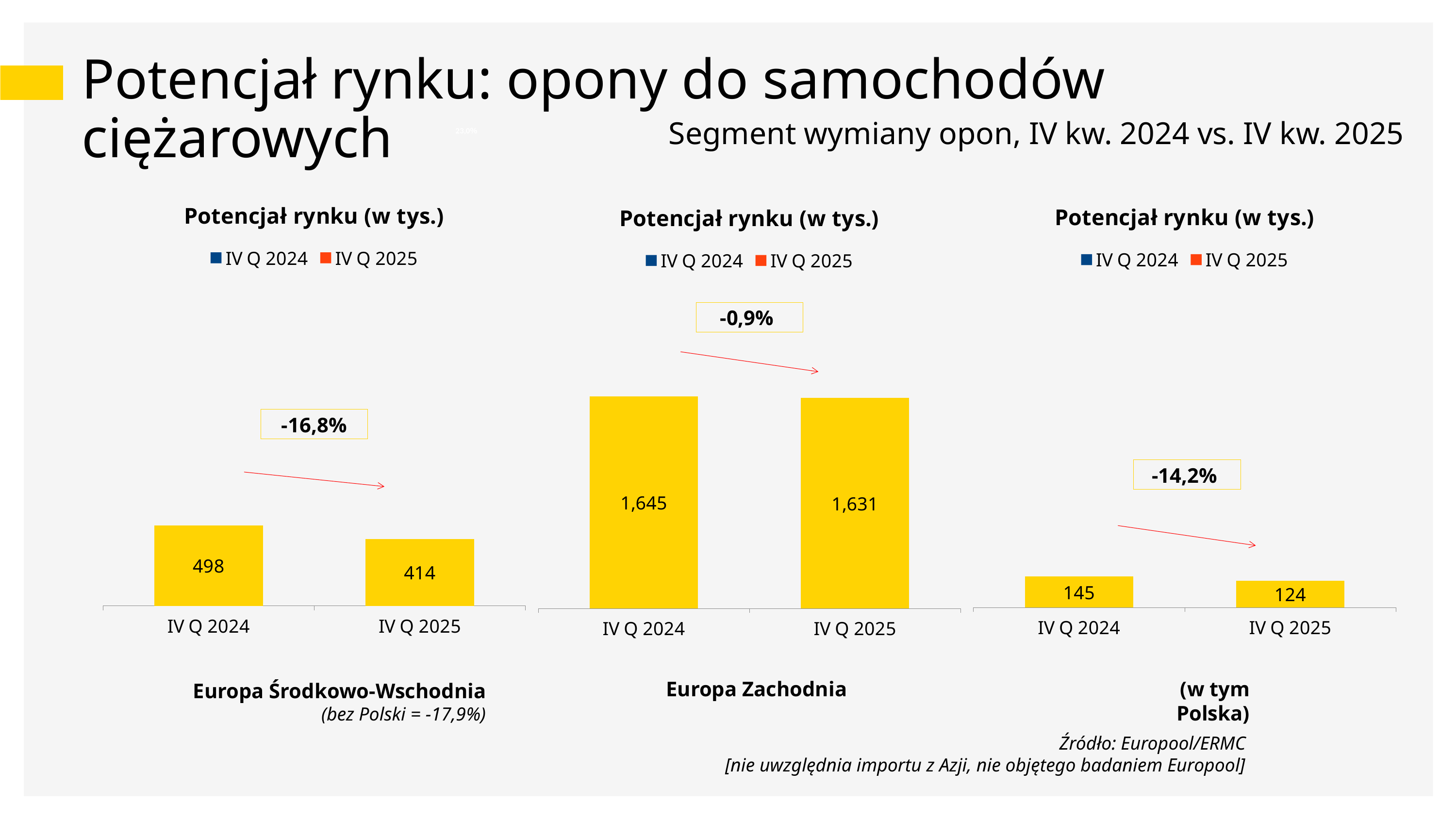
In the left chart (Europa Środkowo-Wschodnia), what is the value for IV Q 2025? 414 In the right chart (Polska), what is the value for IV Q 2025? 124 In the middle chart (Europa Zachodnia), which is larger, IV Q 2024 or IV Q 2025? IV Q 2024 In the middle chart (Europa Zachodnia), what is the value for IV Q 2025? 1,631 How many series does the legend of the middle chart (Europa Zachodnia) list? 2 In the left chart (Europa Środkowo-Wschodnia), what is the value for IV Q 2024? 498 In the right chart (Polska), what is the difference between the IV Q 2024 and IV Q 2025 values? 21 In the left chart (Europa Środkowo-Wschodnia), what is the difference between the IV Q 2024 and IV Q 2025 values? 84 What percentage change is shown above the bars in the middle chart (Europa Zachodnia)? -0,9% In the left chart (Europa Środkowo-Wschodnia), do the values rise or fall from IV Q 2024 to IV Q 2025? fall In the middle chart (Europa Zachodnia), what is the value for IV Q 2024? 1,645 What kind of chart is the right chart (Polska)? bar chart